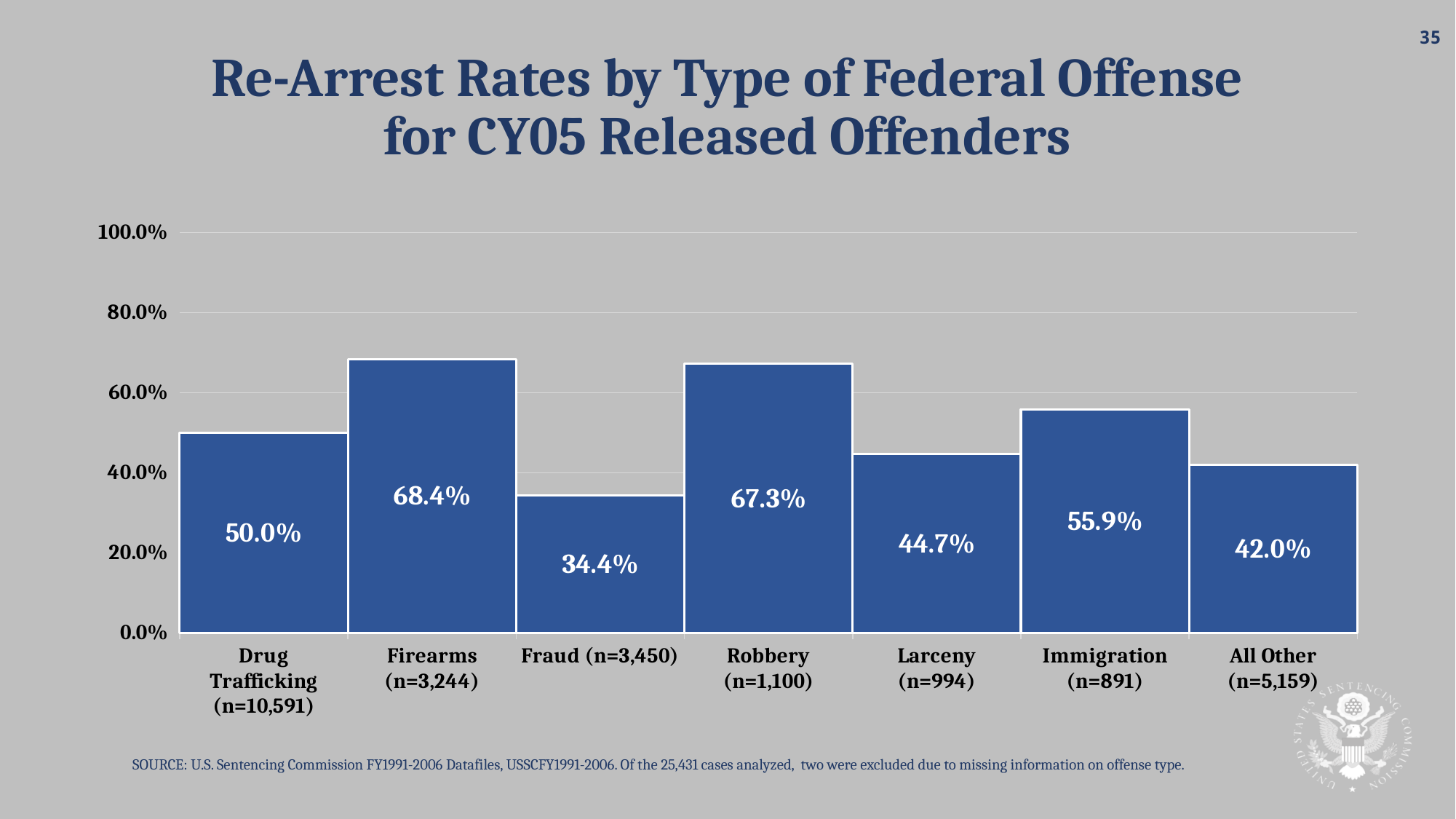
Which offense type has the highest re-arrest rate? Firearms What is the sample size (n) shown for the Drug Trafficking category? 10,591 What is the re-arrest rate for Immigration offenders? 55.9% Which has a higher re-arrest rate, Drug Trafficking or Larceny? Drug Trafficking What is the re-arrest rate for Fraud offenders? 34.4% What is the difference between the re-arrest rates for Firearms and Fraud? 34.0% What is the difference between the re-arrest rates for Immigration and All Other? 13.9% What kind of chart is shown on the slide? Bar chart Is the re-arrest rate for Robbery greater or less than 60.0%? greater How many offense types are shown in the chart? 7 What is the re-arrest rate for Firearms offenders? 68.4% Which offense type has the lowest re-arrest rate? Fraud